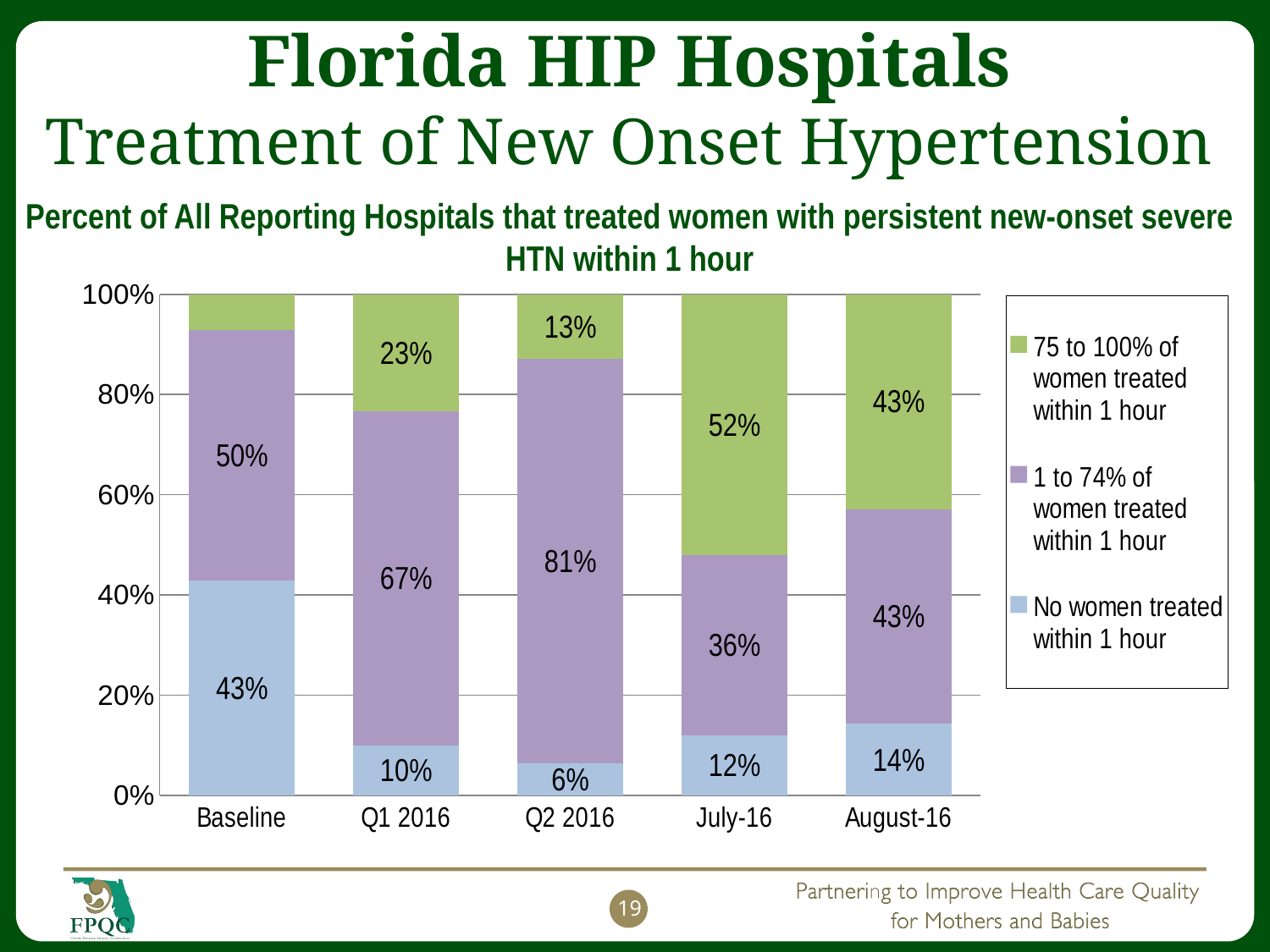
Is the '75 to 100% of women treated within 1 hour' value for Baseline greater or less than 20%? less What is the difference between the '75 to 100% of women treated within 1 hour' values for July-16 and Q1 2016? 29% What is the value for '75 to 100% of women treated within 1 hour' in July-16? 52% What percentage of hospitals had no women treated within 1 hour at Baseline? 43% Which period has the highest value for '1 to 74% of women treated within 1 hour'? Q2 2016 Which period has the lowest value for 'No women treated within 1 hour'? Q2 2016 What kind of chart is shown on the slide? Stacked bar chart Which is larger: the 'No women treated within 1 hour' value for Q1 2016 or for August-16? August-16 How many time periods are shown on the x axis? 5 How many series does the legend list? 3 What is the total of the stacked bar for Q1 2016? 100% What is the value for '1 to 74% of women treated within 1 hour' in Q2 2016? 81%